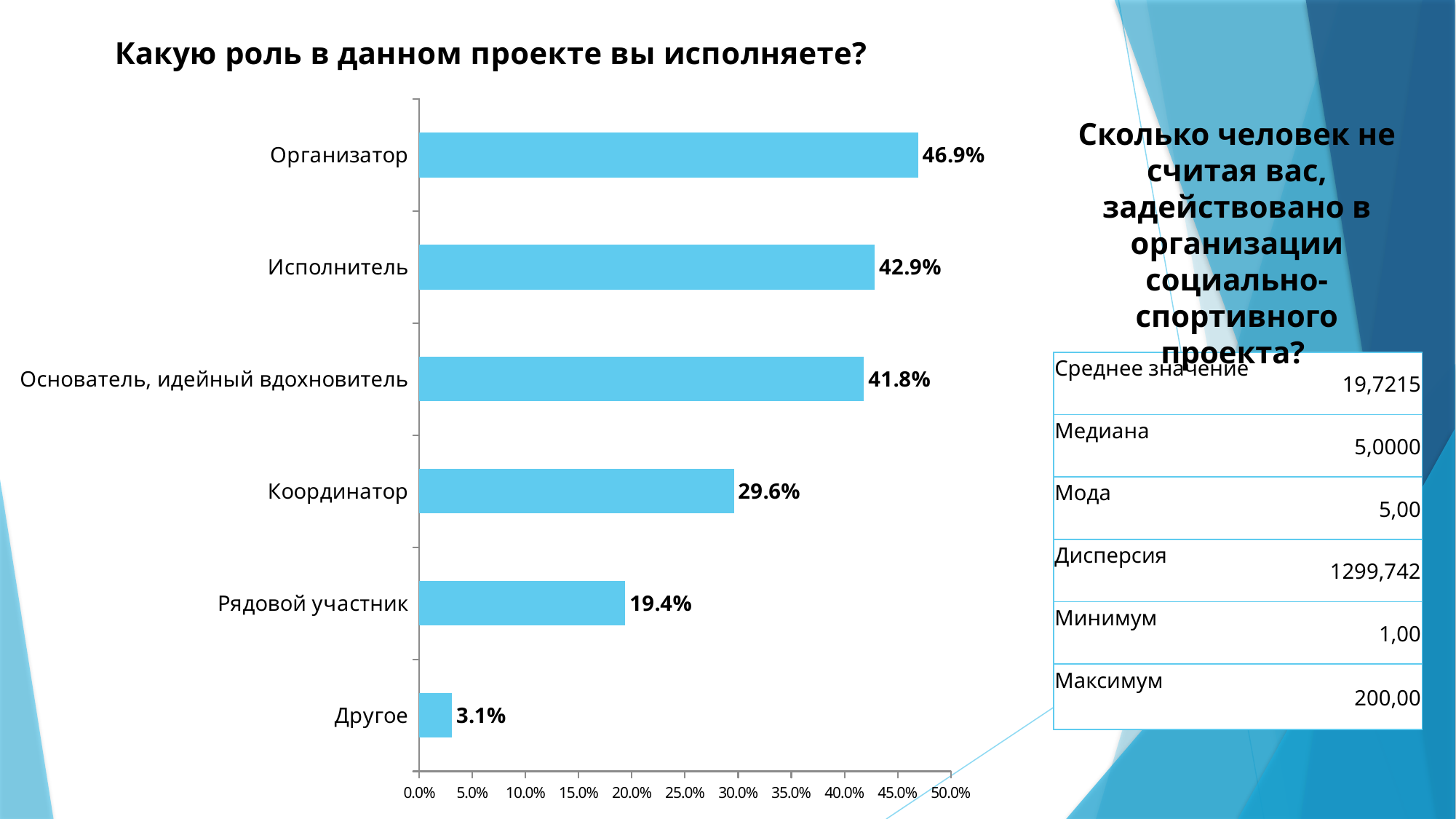
What is the difference between the values for Координатор and Рядовой участник? 10.2% What is the value for Рядовой участник? 19.4% What is the value for Координатор? 29.6% What is the difference between the values for Организатор and Исполнитель? 4.0% What is the title of the chart? Какую роль в данном проекте вы исполняете? Which category has the highest value? Организатор Is the value for Основатель, идейный вдохновитель greater or less than 40.0%? greater What is the value for Организатор? 46.9% What kind of chart is shown on the slide? bar chart Which is larger, the value for Исполнитель or the value for Координатор? Исполнитель How many categories are shown in the chart? 6 Which category has the lowest value? Другое